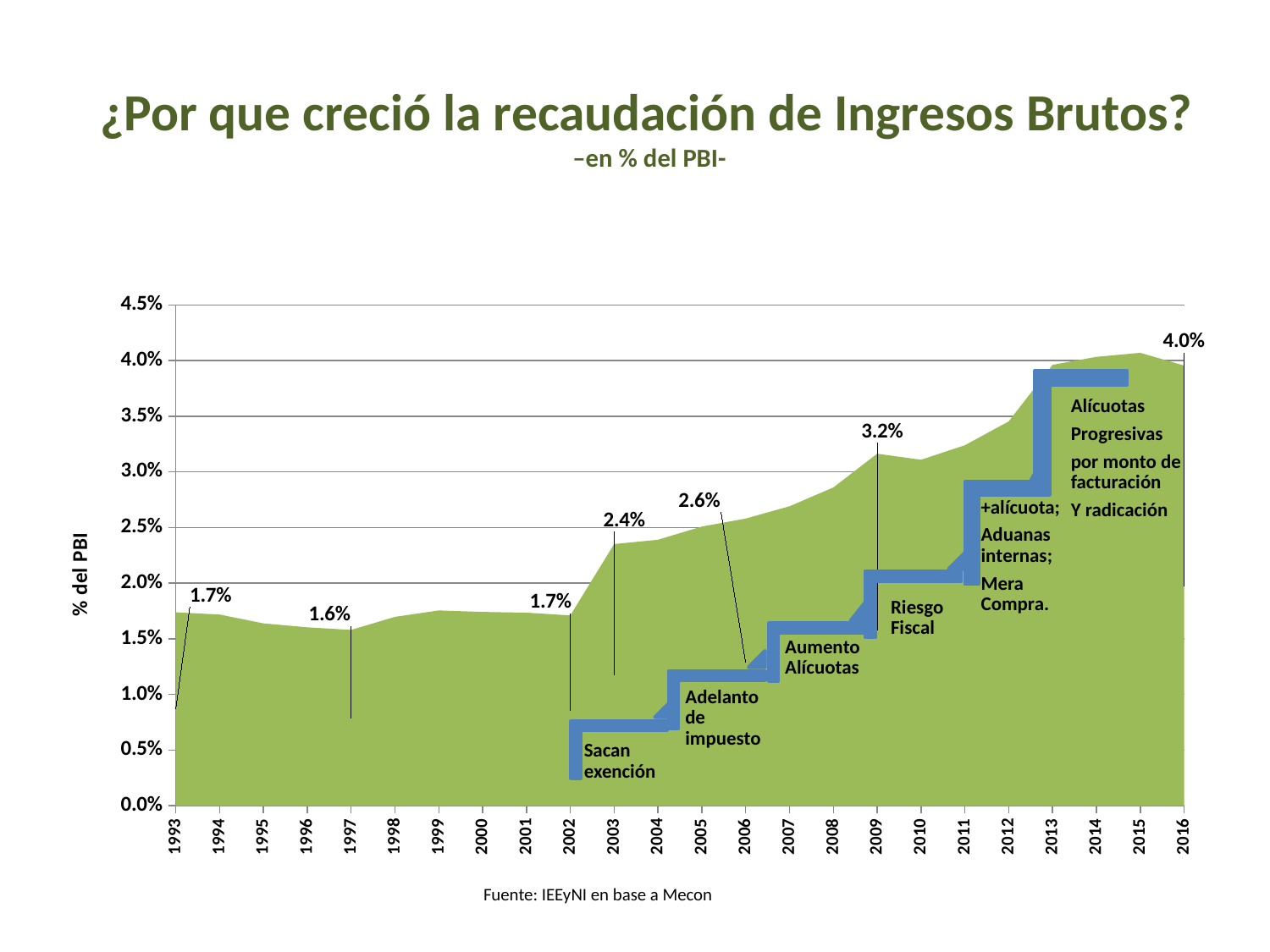
What kind of chart is shown on the slide? area chart What is the value for 1997? 1.6% What is the difference between the value for 2016 and the value for 1993? 2.3% What is the difference between the value for 2003 and the value for 2002? 0.7% What is the value for 2003? 2.4% What is the value for 1993? 1.7% Do the values generally rise or fall from 1993 to 2016? rise What is the value for 2016? 4.0% Is the value for 1999 greater or less than 2.0%? less What is the value for 2009? 3.2% Which year has the larger value, 2009 or 2003? 2009 Is the value for 2013 greater or less than 3.5%? greater